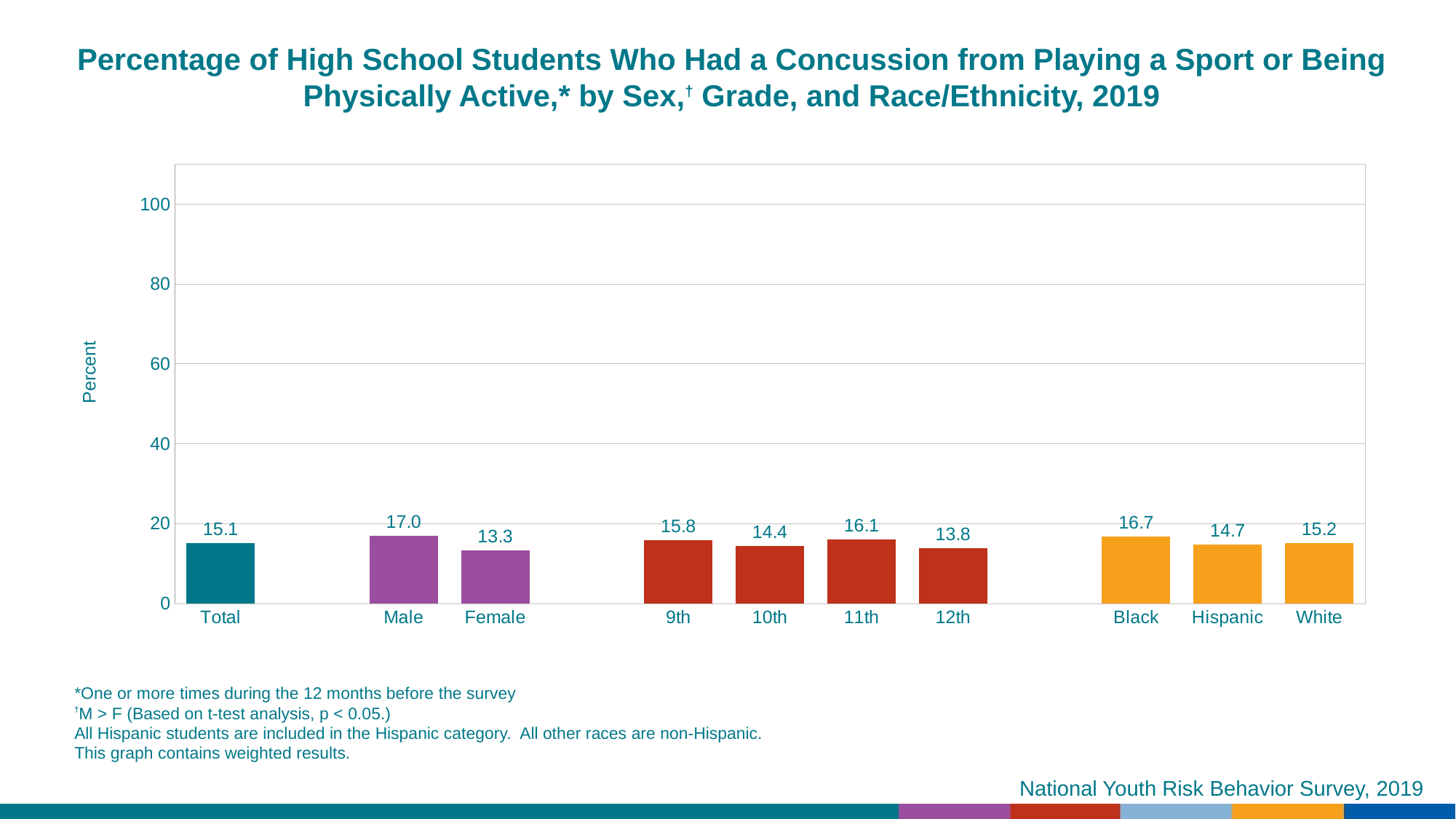
What is the value for Total? 15.1 Which category has the lowest value? Female What is the value for 12th grade? 13.8 How many categories are shown on the x axis? 10 Which is larger, the value for 9th grade or 10th grade? 9th What kind of chart is this? bar chart Which category has the highest value? Male What is the value for Hispanic? 14.7 What is the value for Male? 17.0 What is the label on the y axis? Percent Is the value for Black greater or less than 20? less What is the difference between the Male and Female values? 3.7